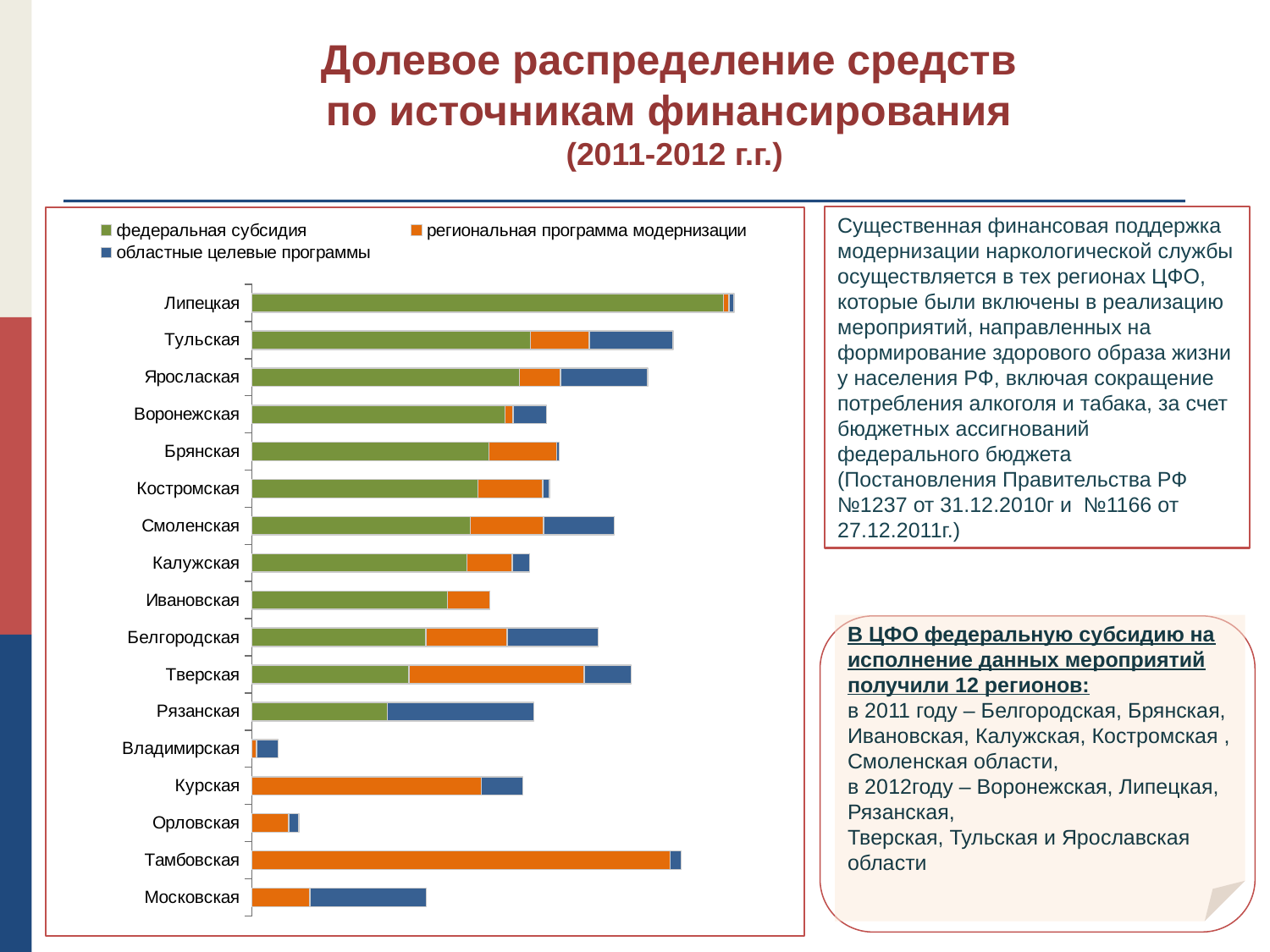
Which region has the longer total bar, Курская or Орловская? Курская Which region has the longest областные целевые программы (blue) segment? Рязанская Which region has the larger федеральная субсидия segment, Тульская or Рязанская? Тульская Which region has the longest региональная программа модернизации (orange) segment? Тамбовская Which region has the longest total bar in the chart? Липецкая What kind of chart is shown on the slide? Stacked horizontal bar chart Which series is shown in orange in the chart? региональная программа модернизации How many regions (categories) are plotted in the chart? 17 Which series is shown in green in the chart? федеральная субсидия How many series does the chart legend list? 3 Which region has the shortest total bar in the chart? Владимирская